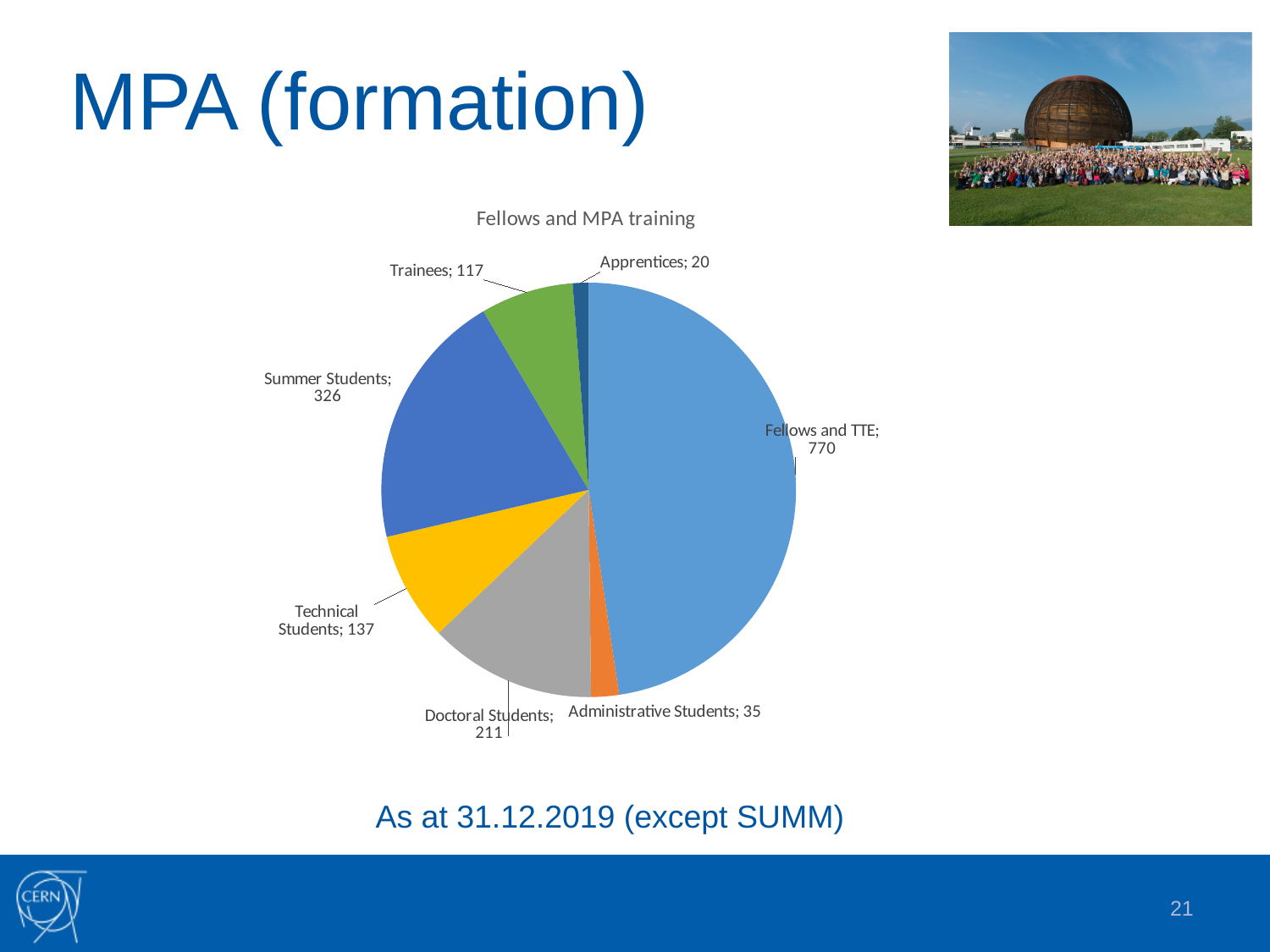
Which category has the smallest slice? Apprentices What is the total of all categories in the pie chart? 1616 Which category has the largest slice? Fellows and TTE What is the difference between Summer Students and Technical Students? 189 What is the value for Doctoral Students? 211 What is the title of the chart? Fellows and MPA training How many categories does the pie chart show? 7 Which is larger, Trainees or Administrative Students? Trainees What is the value for Summer Students? 326 What is the value for Fellows and TTE? 770 What type of chart is shown on the slide? pie chart What is the value for Apprentices? 20